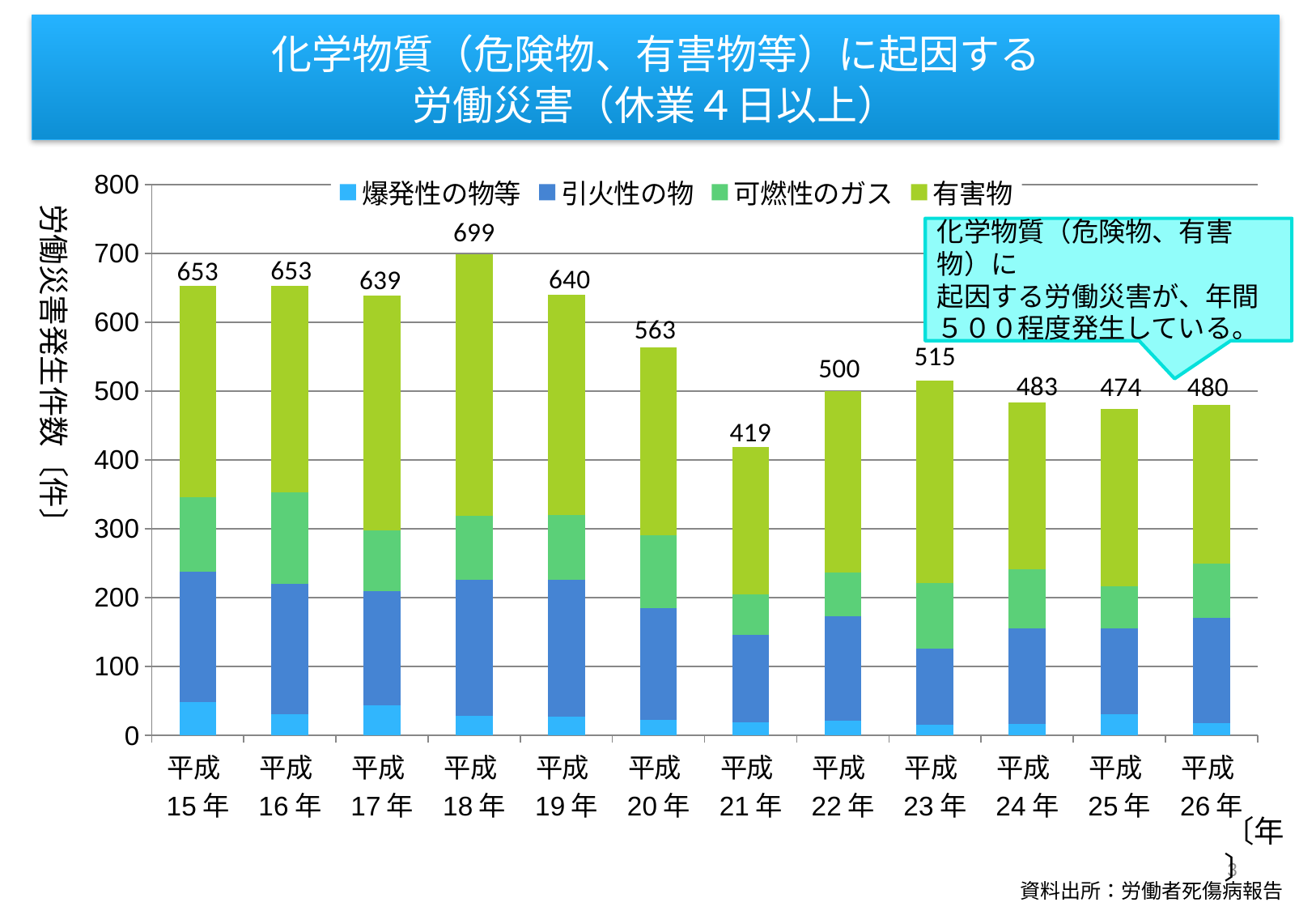
What is the difference between the totals for 平成18年 and 平成21年? 280 What is the total value labelled on the bar for 平成21年? 419 How many series does the legend list? 4 Which year has a larger total, 平成23年 or 平成25年? 平成23年 What is the difference between the totals for 平成15年 and 平成20年? 90 Is the 有害物 segment for 平成18年 greater or less than 300? greater Which year has the highest total number of accidents? 平成18年 What kind of chart is shown on the slide? Stacked bar chart Which year has the lowest total number of accidents? 平成21年 What is the total number of labour accidents shown for 平成18年? 699 How many years are shown on the x axis? 12 What is the total value labelled for 平成26年? 480